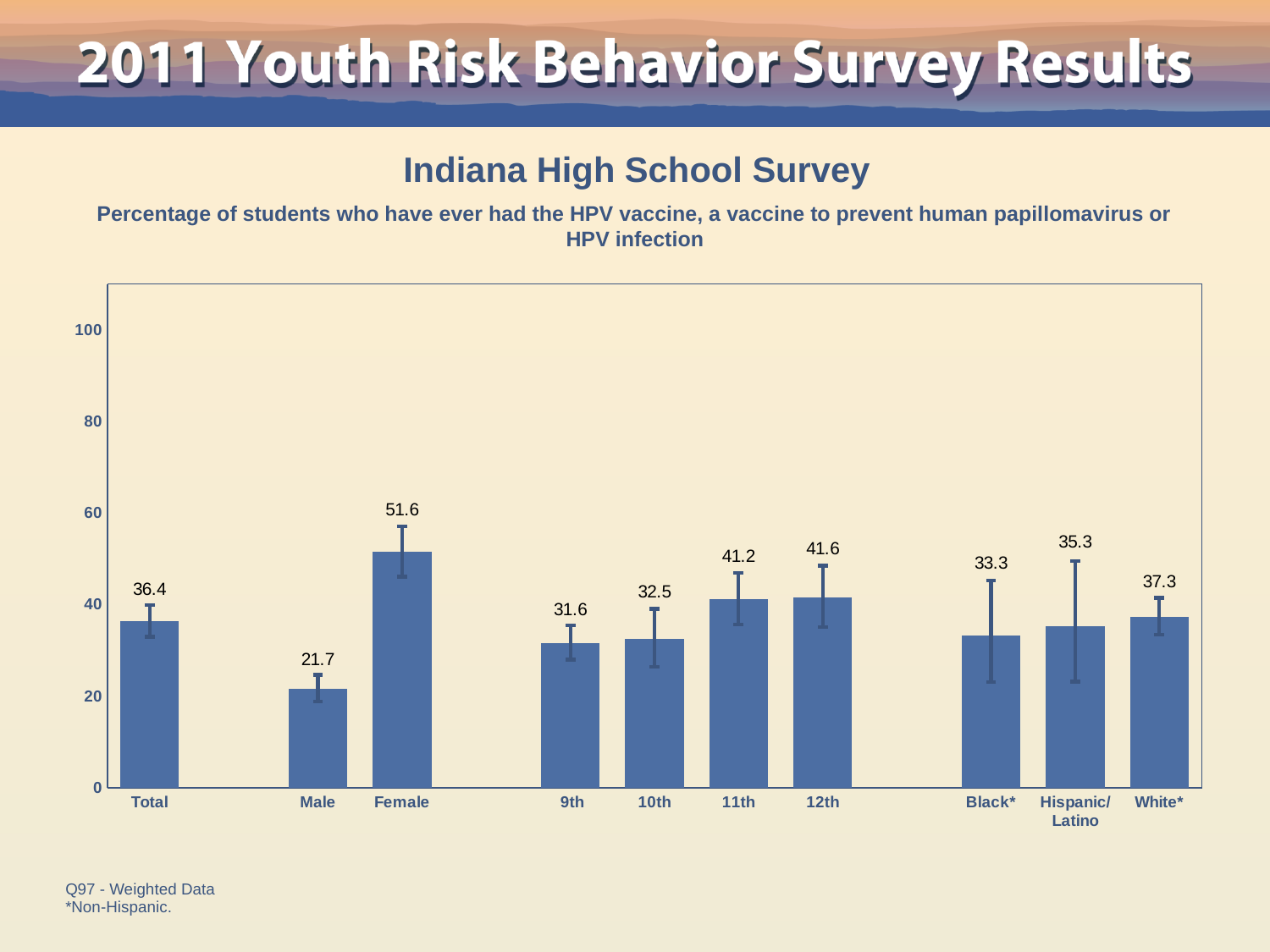
What kind of chart is shown on the slide? bar chart What is the value for Female? 51.6 Which category has the lowest value? Male Which is larger, the value for 9th or the value for 12th? 12th Which category has the highest value? Female What is the difference between the values for White* and Black*? 4.0 Do the values rise or fall from 9th to 12th grade? rise What is the value for Total? 36.4 How many categories are shown on the x axis? 10 What is the difference between the values for Female and Male? 29.9 Is the value for 11th greater or less than 40? greater What is the value for Hispanic/Latino? 35.3